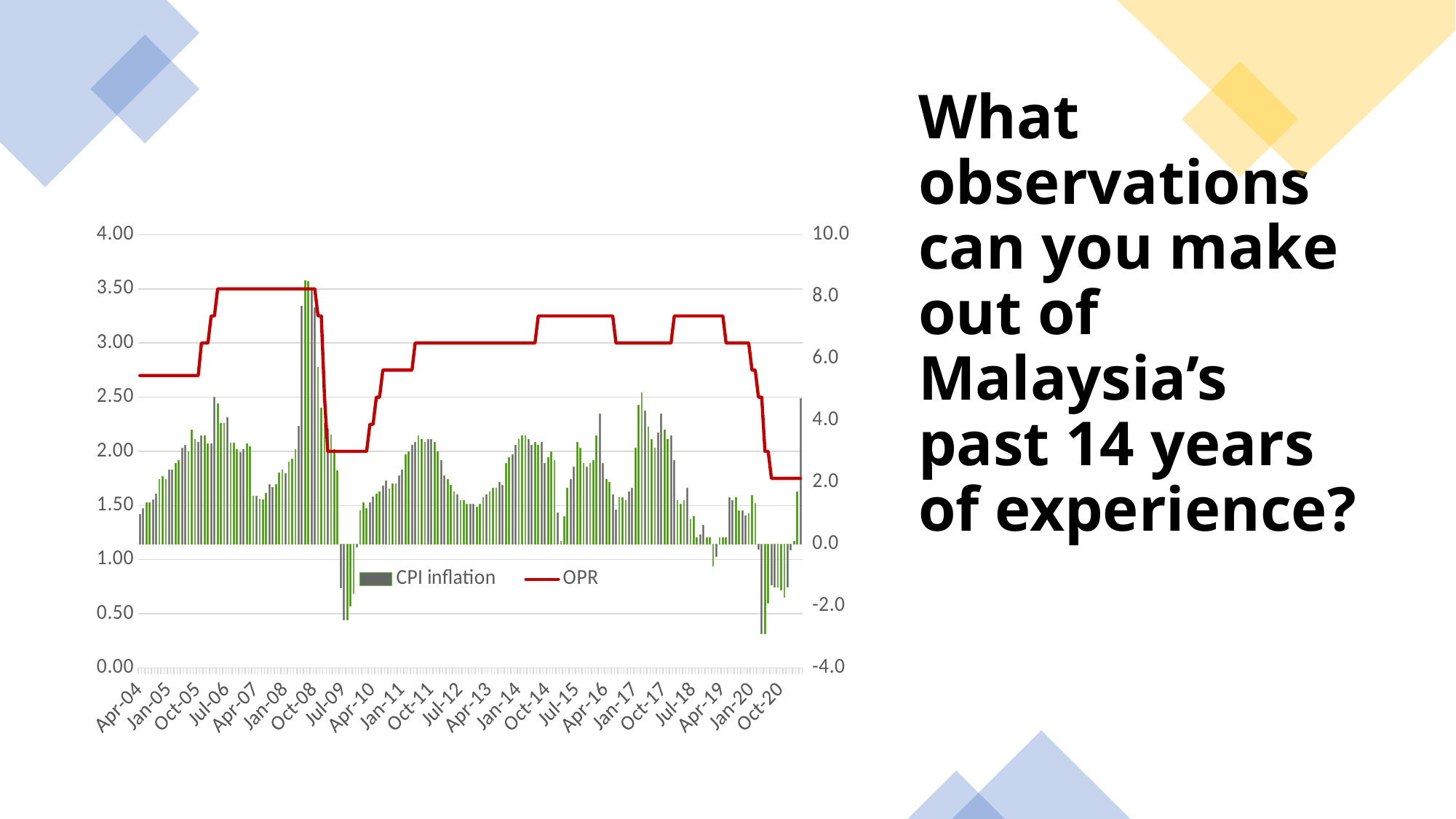
Is the CPI inflation value around Jul-09 greater or less than 0.0 on the right axis? less Does the OPR line rise or fall between Jan-20 and Oct-20? fall Is the peak CPI inflation value around Oct-08 greater or less than 6.0 on the right axis? greater What are the two series named in the legend? CPI inflation and OPR Which series is drawn as a red line? OPR What is the OPR value during the long plateau around Jul-12? 3.00 What is the OPR value during the plateau in mid-2009? 2.00 How many series does the legend list? 2 In which period does the OPR reach its lowest level on the chart? 2020 (after Jan-20) What kind of chart is shown on the slide? A combination bar and line chart What is the OPR value during 2007, when the red line is at its highest plateau? 3.50 Is the OPR value at the end of the series (Oct-20) higher or lower than the OPR value at the start (Apr-04)? lower